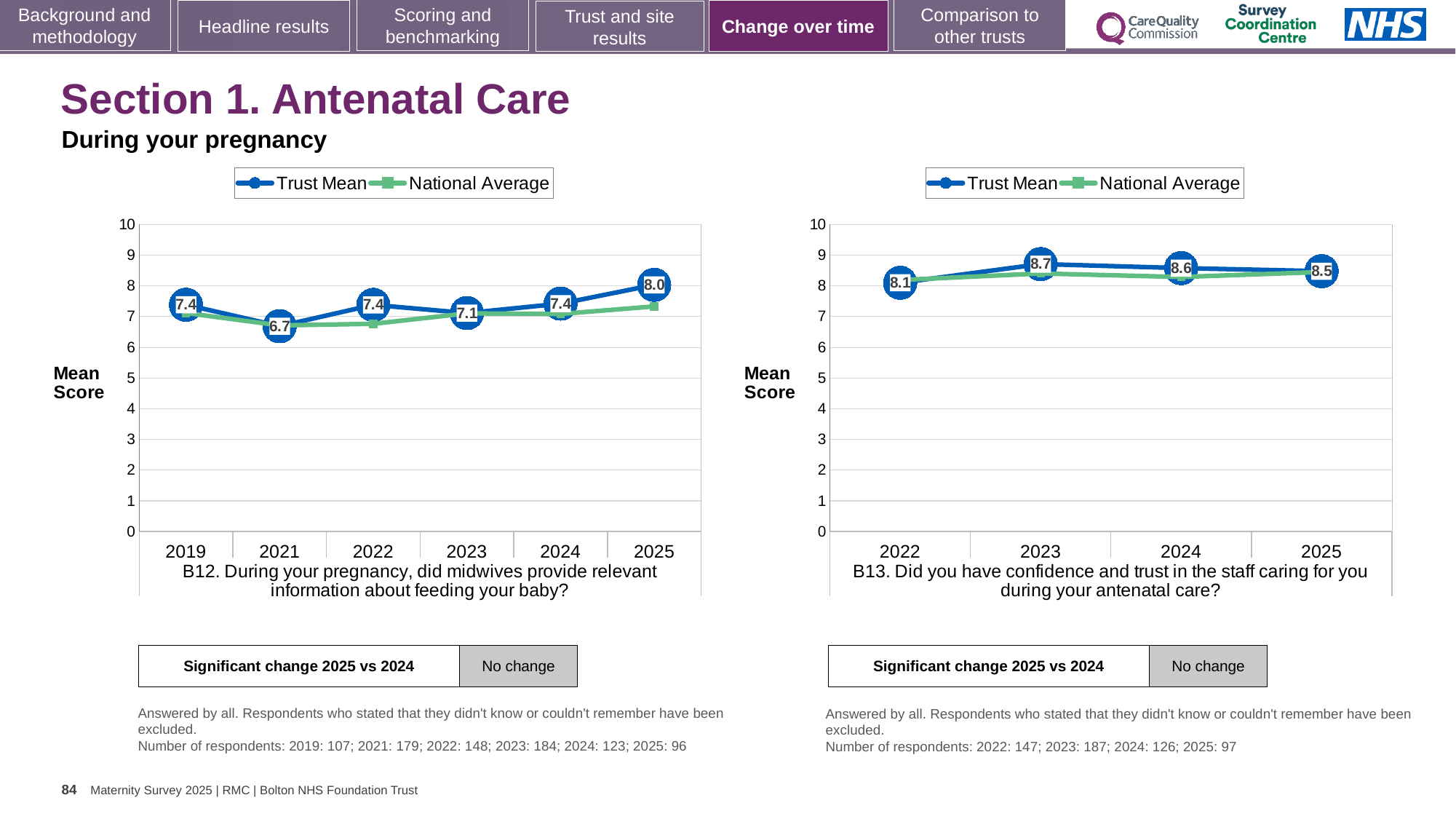
In the B13 chart (right), what is the Trust Mean for 2022? 8.1 What kind of chart is the B12 chart (left)? line chart How many years are plotted on the x axis of the B12 chart (left)? 6 How many series does the legend of the B13 chart (right) list? 2 In the B13 chart (right), which year has the lowest Trust Mean? 2022 In the B12 chart (left), what is the difference between the Trust Mean for 2025 and the Trust Mean for 2024? 0.6 In the B13 chart (right), is the Trust Mean for 2023 larger or smaller than the Trust Mean for 2022? larger In the B12 chart (left), what is the Trust Mean for 2025? 8.0 In the B13 chart (right), what is the Trust Mean for 2023? 8.7 In the B12 chart (left), which year has the lowest Trust Mean? 2021 In the B12 chart (left), which year has the highest Trust Mean? 2025 In the B12 chart (left), what is the Trust Mean for 2021? 6.7